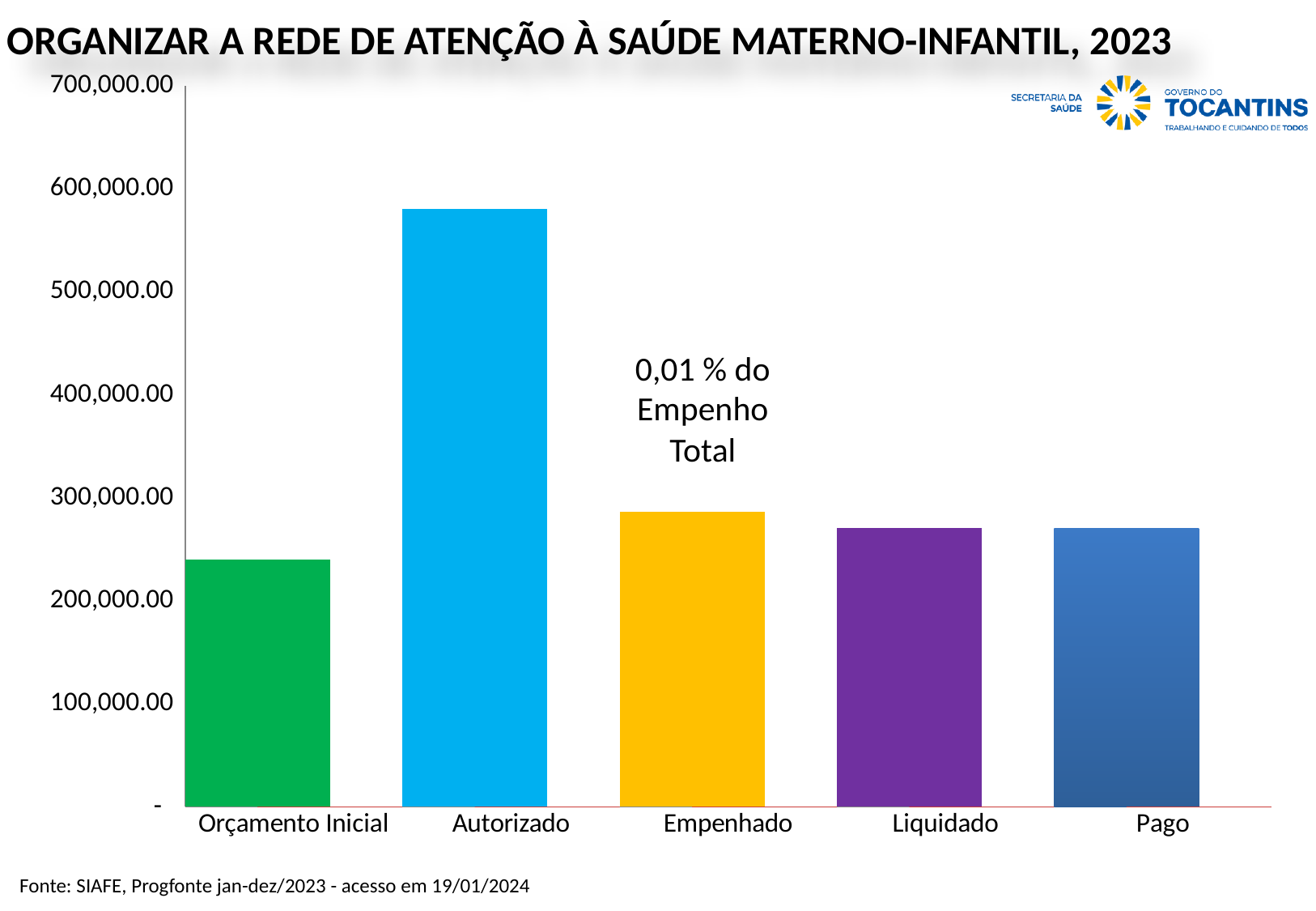
What kind of chart is shown on the slide? bar chart Is the value for Pago greater or less than 300,000.00? less Which is larger, the value for Autorizado or the value for Empenhado? Autorizado Which category has the lowest bar? Orçamento Inicial What text annotation appears above the Empenhado bar? 0,01 % do Empenho Total Which category has the highest bar? Autorizado How many categories are shown on the x axis of the chart? 5 Is the value for Orçamento Inicial greater or less than 300,000.00? less Which is larger, the value for Orçamento Inicial or the value for Liquidado? Liquidado What is the title of the chart? ORGANIZAR A REDE DE ATENÇÃO À SAÚDE MATERNO-INFANTIL, 2023 Is the value for Autorizado greater or less than 500,000.00? greater